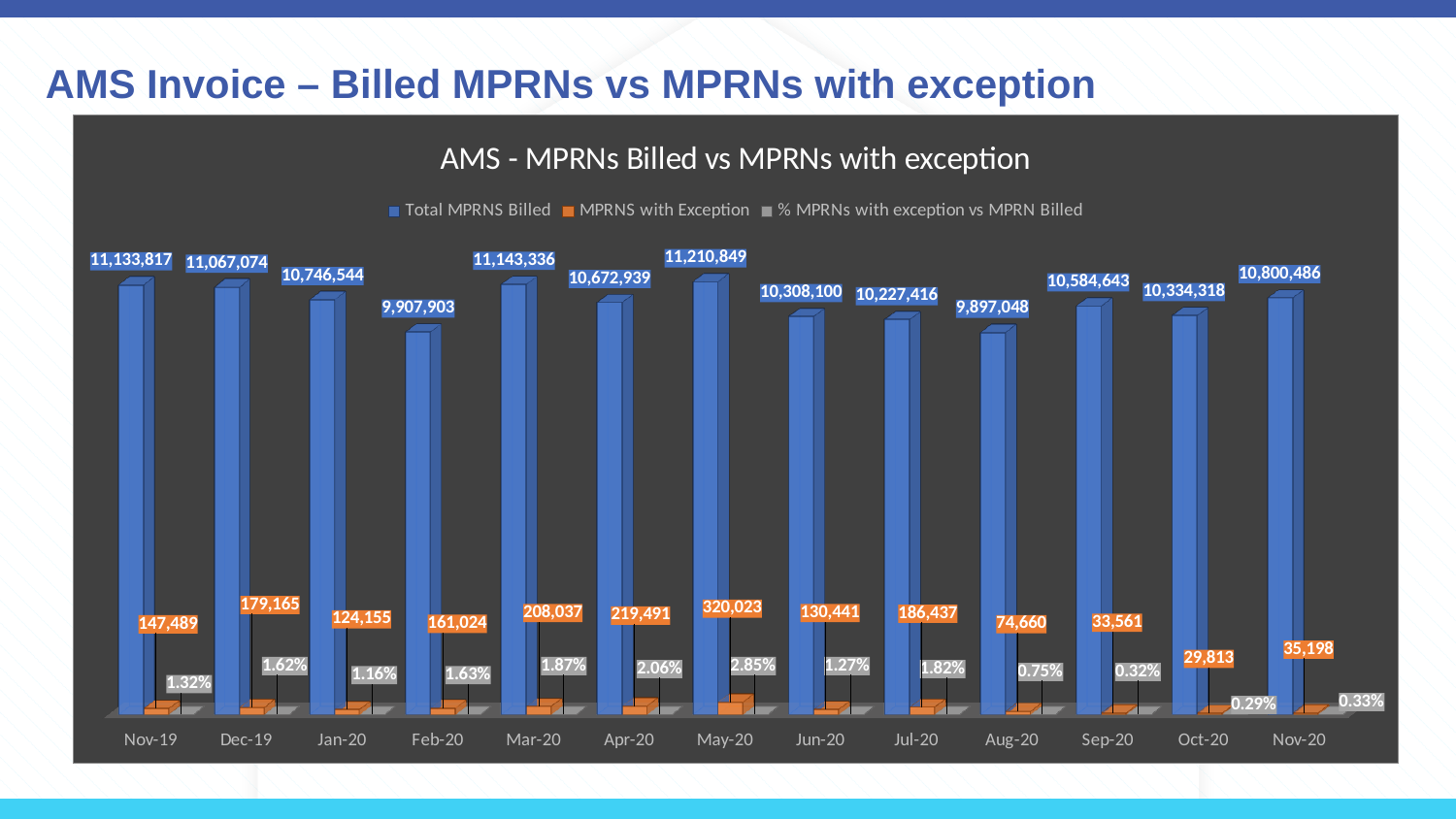
How many series does the legend list? 3 What is the % MPRNs with exception vs MPRN Billed for Apr-20? 2.06% What is the Total MPRNS Billed value for Feb-20? 9,907,903 Which month has the lowest MPRNS with Exception? Oct-20 How many months are shown on the x axis? 13 Which month has the highest % MPRNs with exception vs MPRN Billed? May-20 What is the difference between the MPRNS with Exception values for May-20 and Apr-20? 100,532 What is the MPRNS with Exception value for Jul-20? 186,437 Which month has the highest Total MPRNS Billed? May-20 Which is larger, the Total MPRNS Billed for Nov-19 or for Nov-20? Nov-19 What kind of chart is shown on the slide? Bar chart What is the title of the chart? AMS - MPRNs Billed vs MPRNs with exception